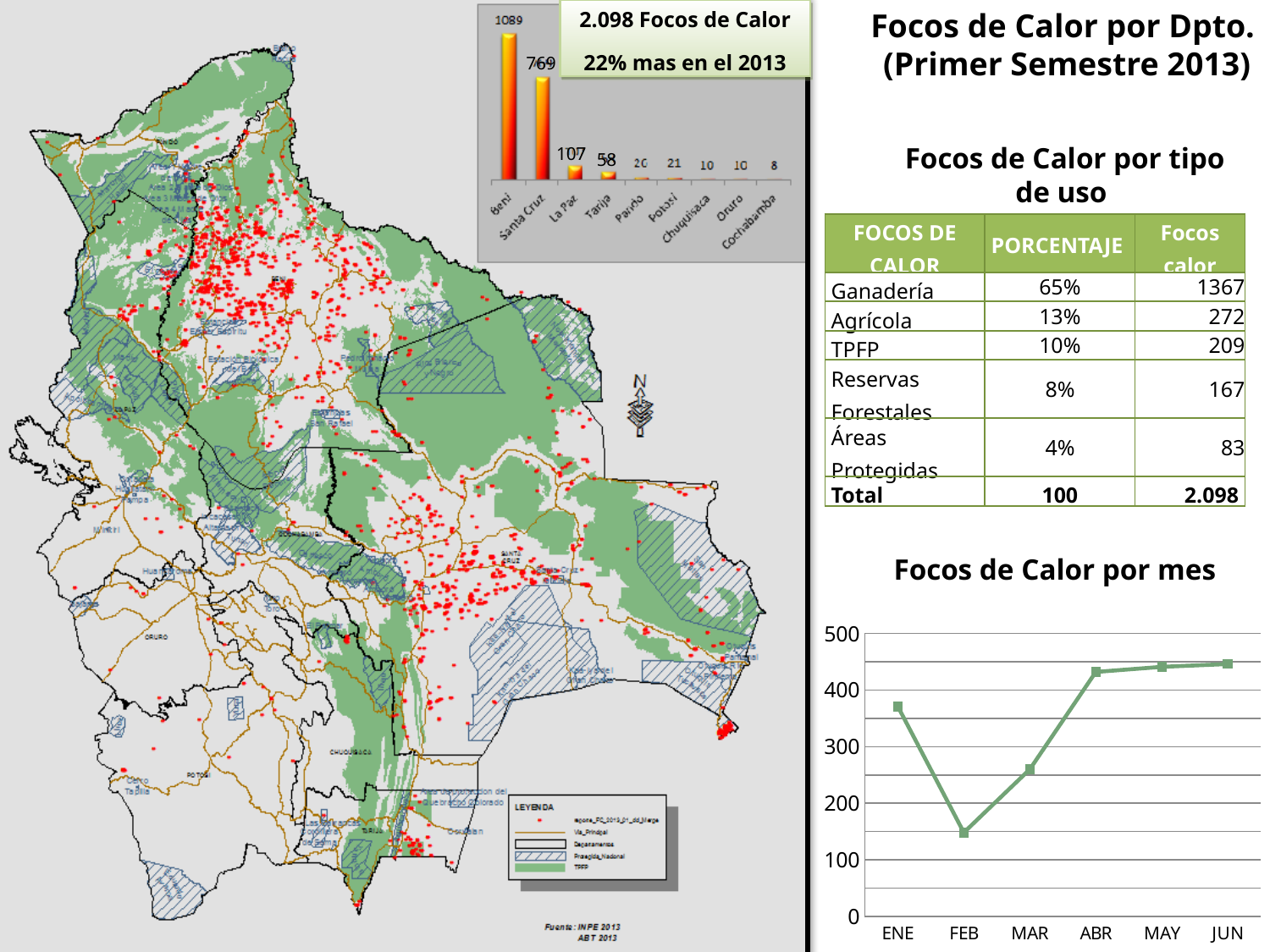
What kind of chart is the chart at the top of the slide showing focos de calor by department? Bar chart In the bar chart at the top of the slide, which department has the lowest value? Cochabamba In the 'Focos de Calor por mes' chart, is the value for FEB greater or less than 200? less In the 'Focos de Calor por mes' chart, is the value for ENE greater or less than 300? greater How many departments are shown in the bar chart at the top of the slide? 9 In the 'Focos de Calor por mes' chart, do the values rise or fall from FEB to JUN? rise In the bar chart at the top of the slide, what is the difference between the values for Beni and Santa Cruz? 320 In the bar chart at the top of the slide, what is the value for Santa Cruz? 769 In the bar chart at the top of the slide, how many focos de calor are shown for Beni? 1089 In the 'Focos de Calor por mes' chart, which month has the lowest value? FEB In the bar chart at the top of the slide, which is larger, the value for La Paz or the value for Tarija? La Paz In the bar chart at the top of the slide, which department has the highest value? Beni